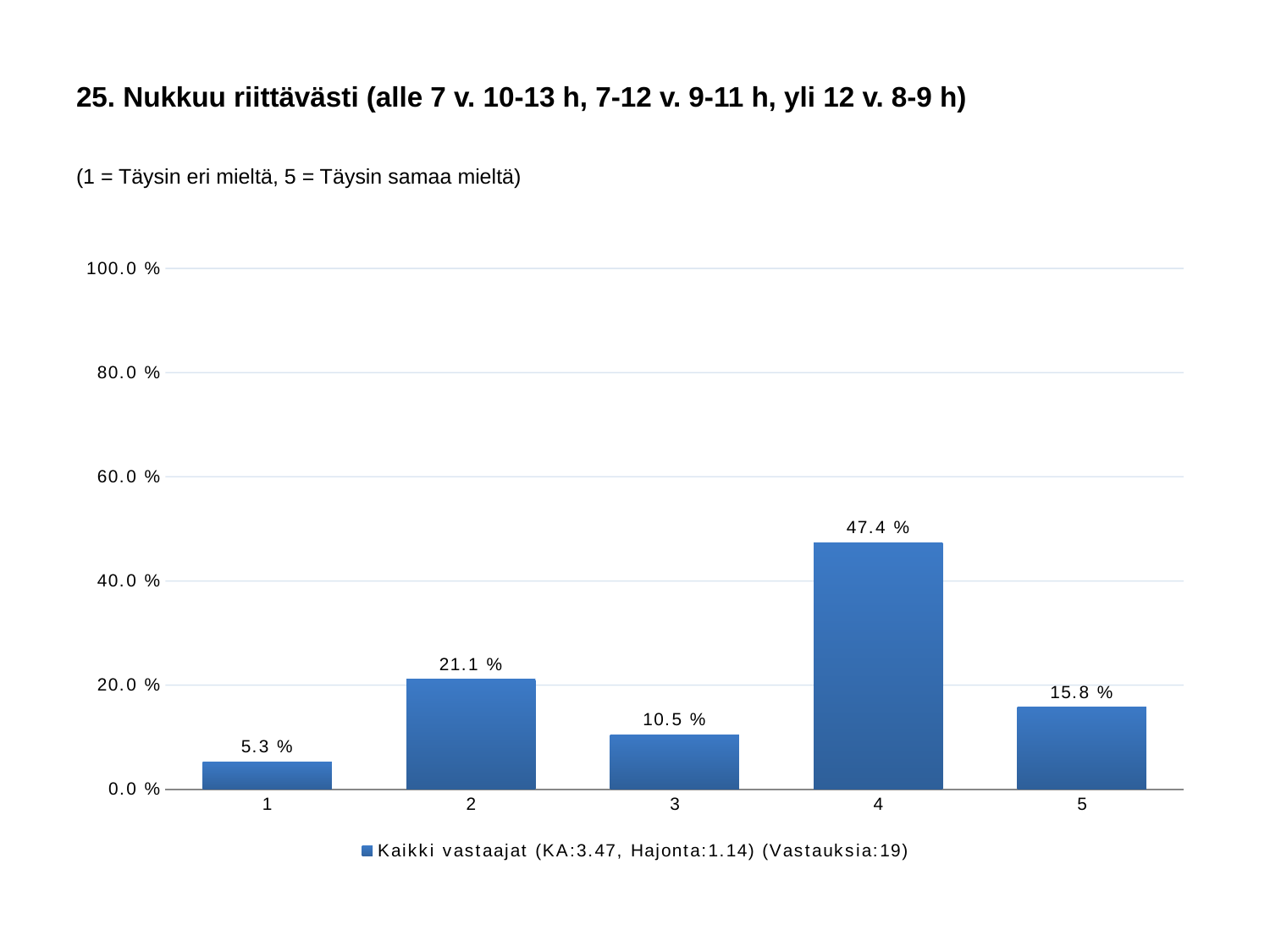
Which is larger, the value for category 2 or the value for category 5? 2 How many series does the legend list? 1 What is the difference between the values for category 2 and category 3? 10.6 % Which category has the lowest value? 1 What kind of chart is shown? bar chart What is the value for category 5? 15.8 % What is the value for category 4? 47.4 % How many categories are shown on the x axis? 5 What is the value for category 1? 5.3 % How many responses (Vastauksia) does the legend report? 19 Which category has the highest value? 4 Is the value for category 4 greater or less than 40.0 %? greater